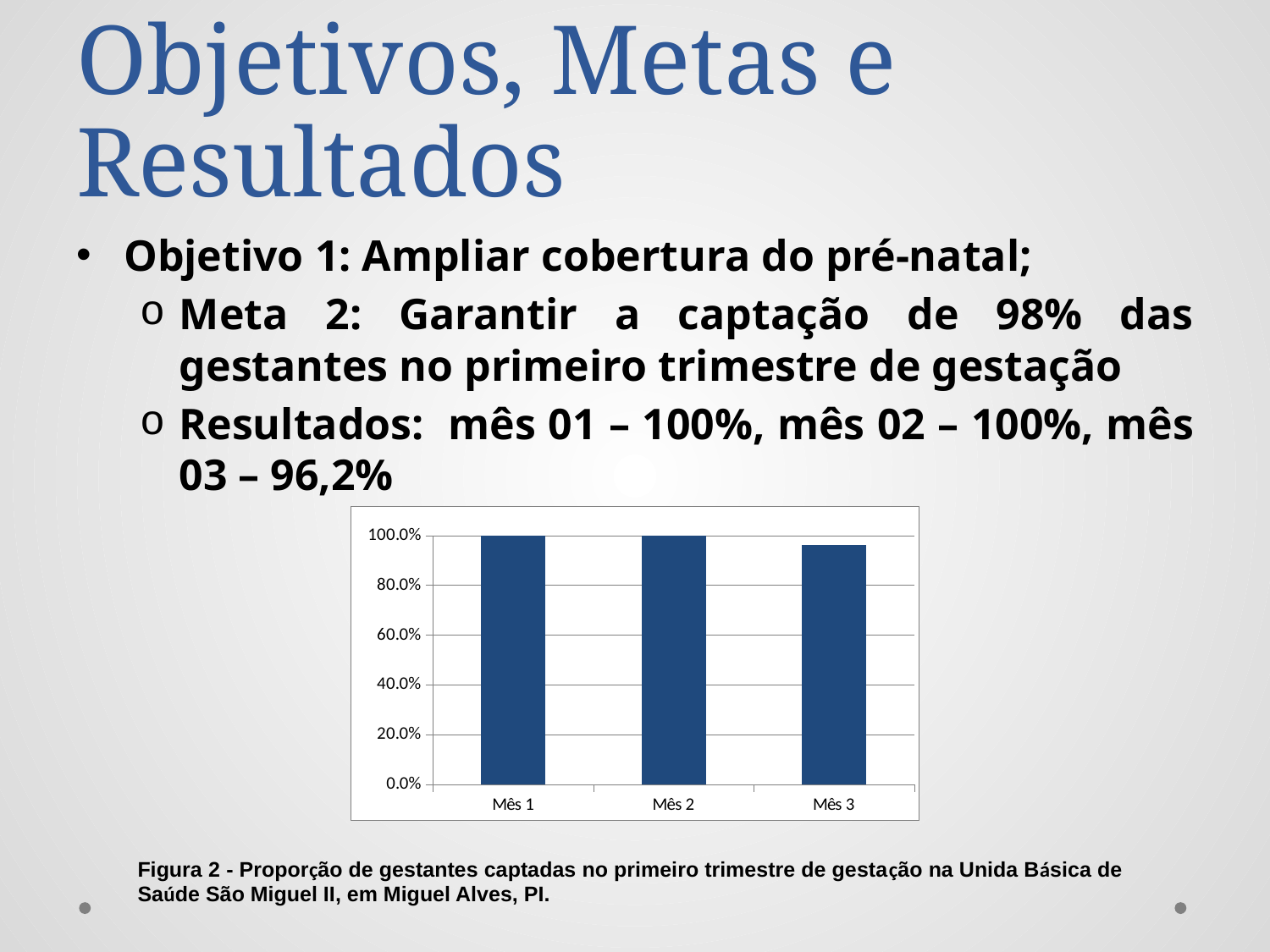
What is the value for Mês 2 in the chart? 100.0% What is the value for Mês 1 in the chart? 100.0% Which month has the lowest bar in the chart? Mês 3 What type of chart is shown on the slide? bar chart According to the slide, what proportion was reached in mês 03? 96,2% What figure number is given in the caption below the chart? Figura 2 Which is larger, the value for Mês 1 or the value for Mês 3? Mês 1 How many categories (months) are plotted in the chart? 3 What is the difference between the result for mês 01 and the result for mês 03 stated on the slide? 3,8% Is the value for Mês 3 greater or less than 80.0%? greater What is the highest tick value shown on the vertical axis of the chart? 100.0% Do the values rise or fall from Mês 2 to Mês 3? fall